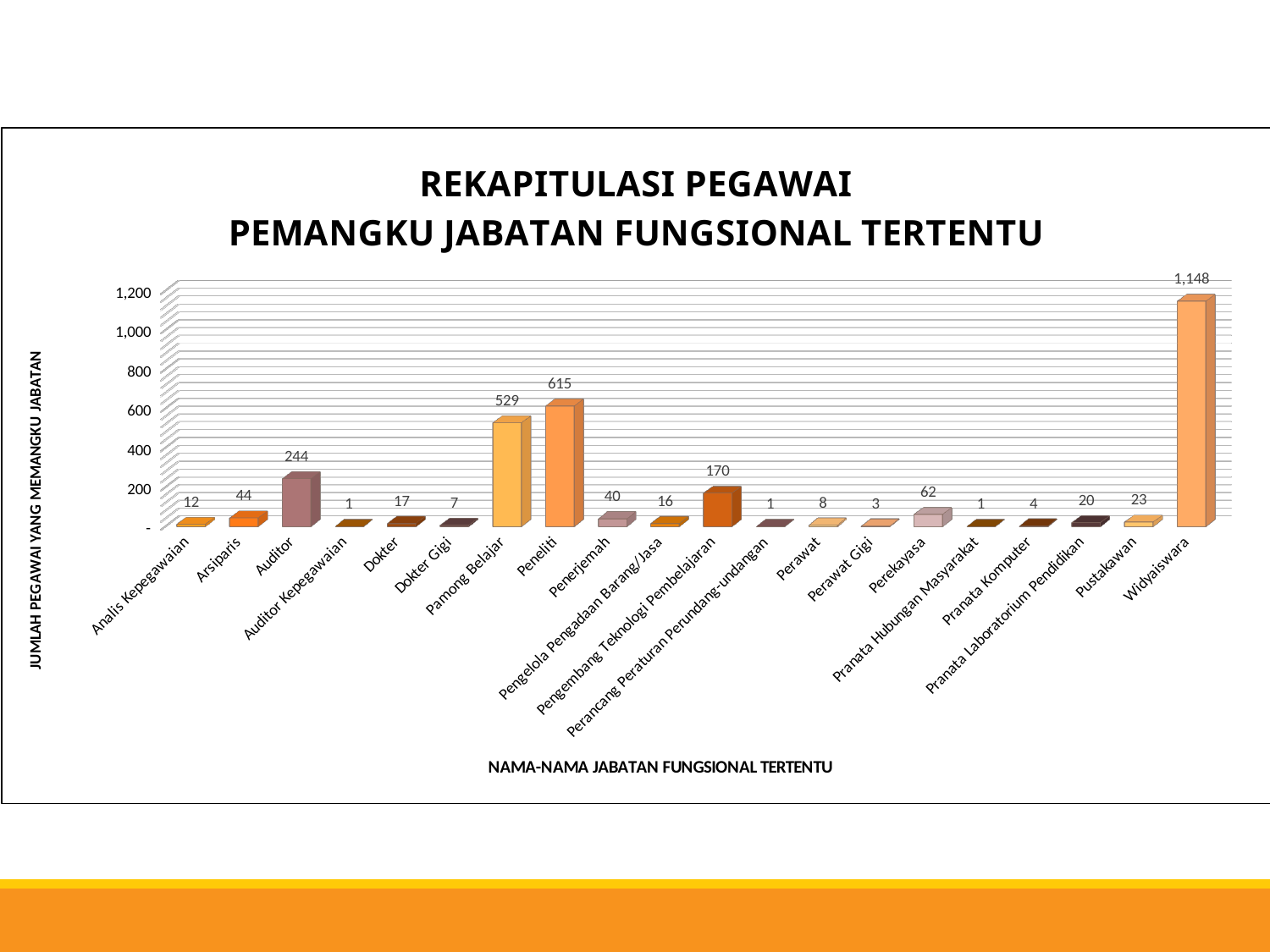
What is the value for Auditor? 244 Which is larger, the value for Arsiparis or the value for Penerjemah? Arsiparis What is the difference between the values for Peneliti and Pamong Belajar? 86 Which category has the highest value? Widyaiswara What is the value for Pengembang Teknologi Pembelajaran? 170 What is the value for Widyaiswara? 1,148 How many categories are shown on the x axis? 20 What is the value for Perekayasa? 62 What is the difference between the values for Widyaiswara and Peneliti? 533 What kind of chart is shown on the slide? Bar chart Is the value for Widyaiswara greater or less than 1,000? greater What is the value for Pamong Belajar? 529